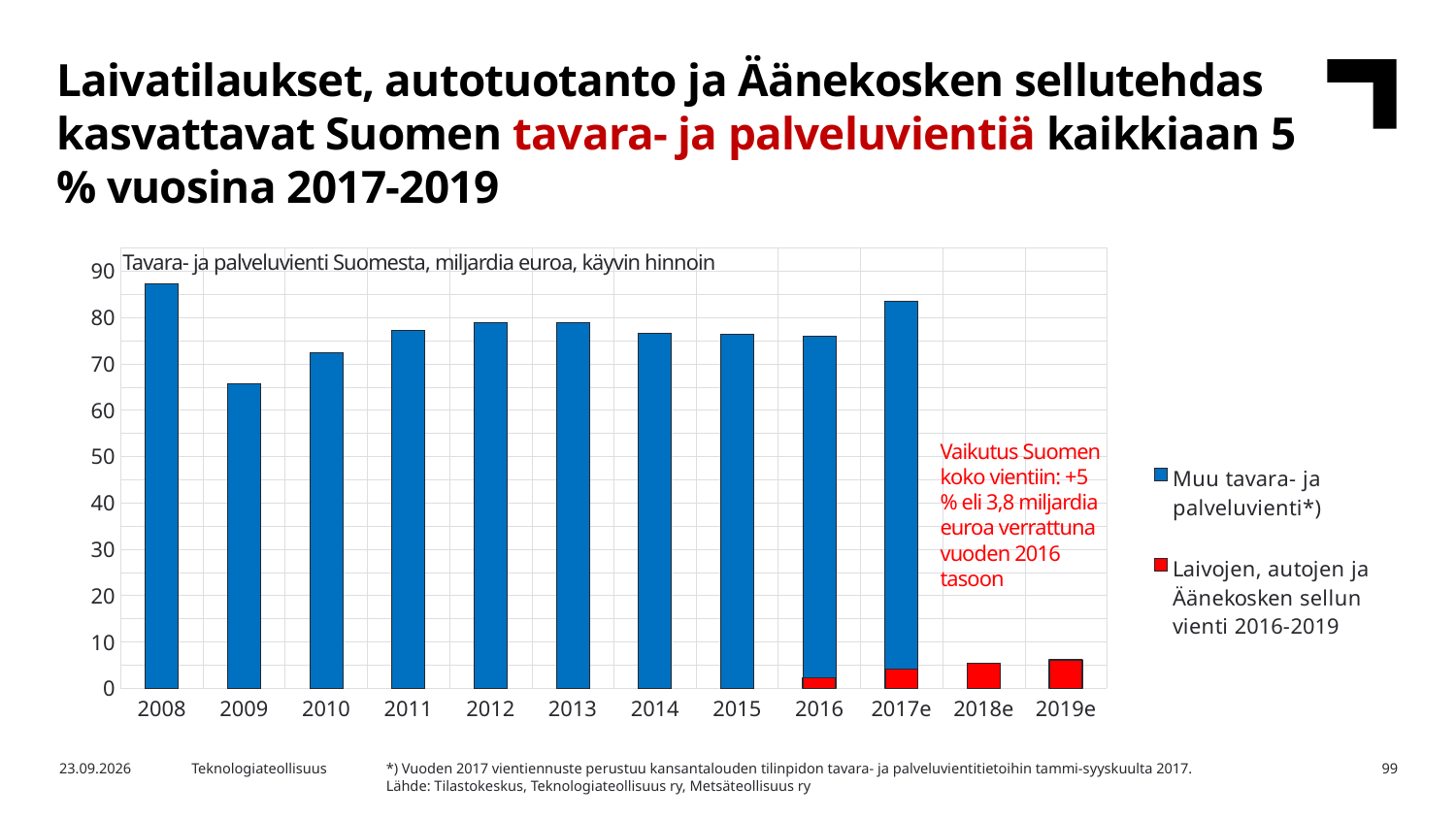
How many series does the chart legend list? 2 What kind of chart is shown on the slide? bar chart Is the value for 'Muu tavara- ja palveluvienti*)' in 2008 greater or less than 80? greater Which year has the larger bar for 'Muu tavara- ja palveluvienti*)', 2008 or 2009? 2008 Among the years 2008 to 2017e, which year has the lowest bar for 'Muu tavara- ja palveluvienti*)'? 2009 What is the title of the chart? Tavara- ja palveluvienti Suomesta, miljardia euroa, käyvin hinnoin Is the value for 'Muu tavara- ja palveluvienti*)' in 2009 greater or less than 70? less Which year has the tallest bar for 'Muu tavara- ja palveluvienti*)'? 2008 How many years are shown on the x axis of the chart? 12 Does the total bar height rise or fall from 2016 to 2017e? rise Is the value for 'Laivojen, autojen ja Äänekosken sellun vienti 2016-2019' in 2019e greater or less than 10? less